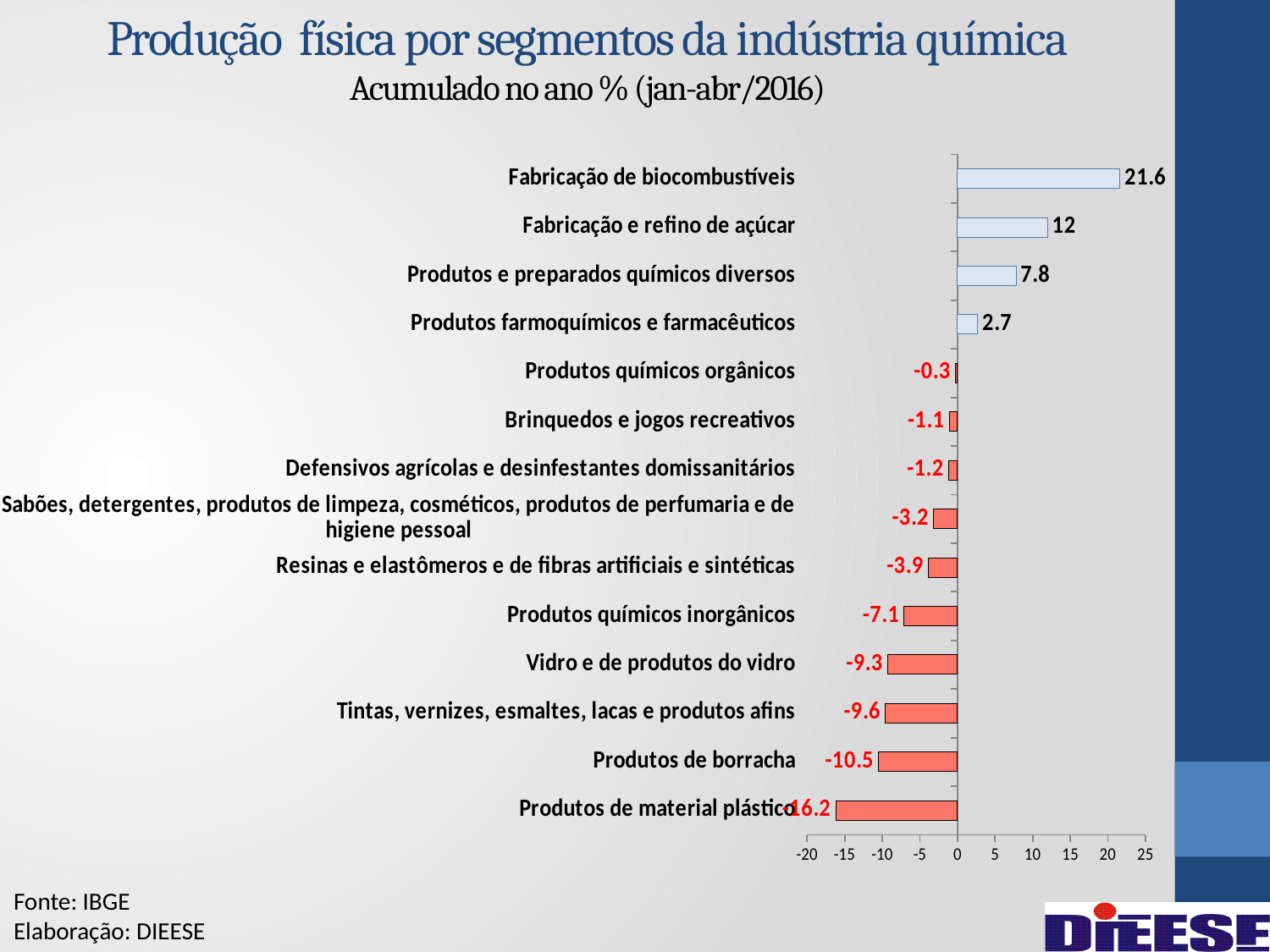
Is the value for Produtos de material plástico greater or less than -15? less What is the value for Fabricação de biocombustíveis? 21.6 Which is larger, the value for Produtos químicos inorgânicos or the value for Resinas e elastômeros e de fibras artificiais e sintéticas? Resinas e elastômeros e de fibras artificiais e sintéticas Which segment has the highest value? Fabricação de biocombustíveis How many segments are shown in the chart? 14 What is the value for Vidro e de produtos do vidro? -9.3 What is the difference between the values for Fabricação de biocombustíveis and Fabricação e refino de açúcar? 9.6 What kind of chart is shown on the slide? bar chart What is the value for Produtos farmoquímicos e farmacêuticos? 2.7 Which segment has the lowest value? Produtos de material plástico What is the value for Produtos de borracha? -10.5 What is the source cited for the chart data? IBGE